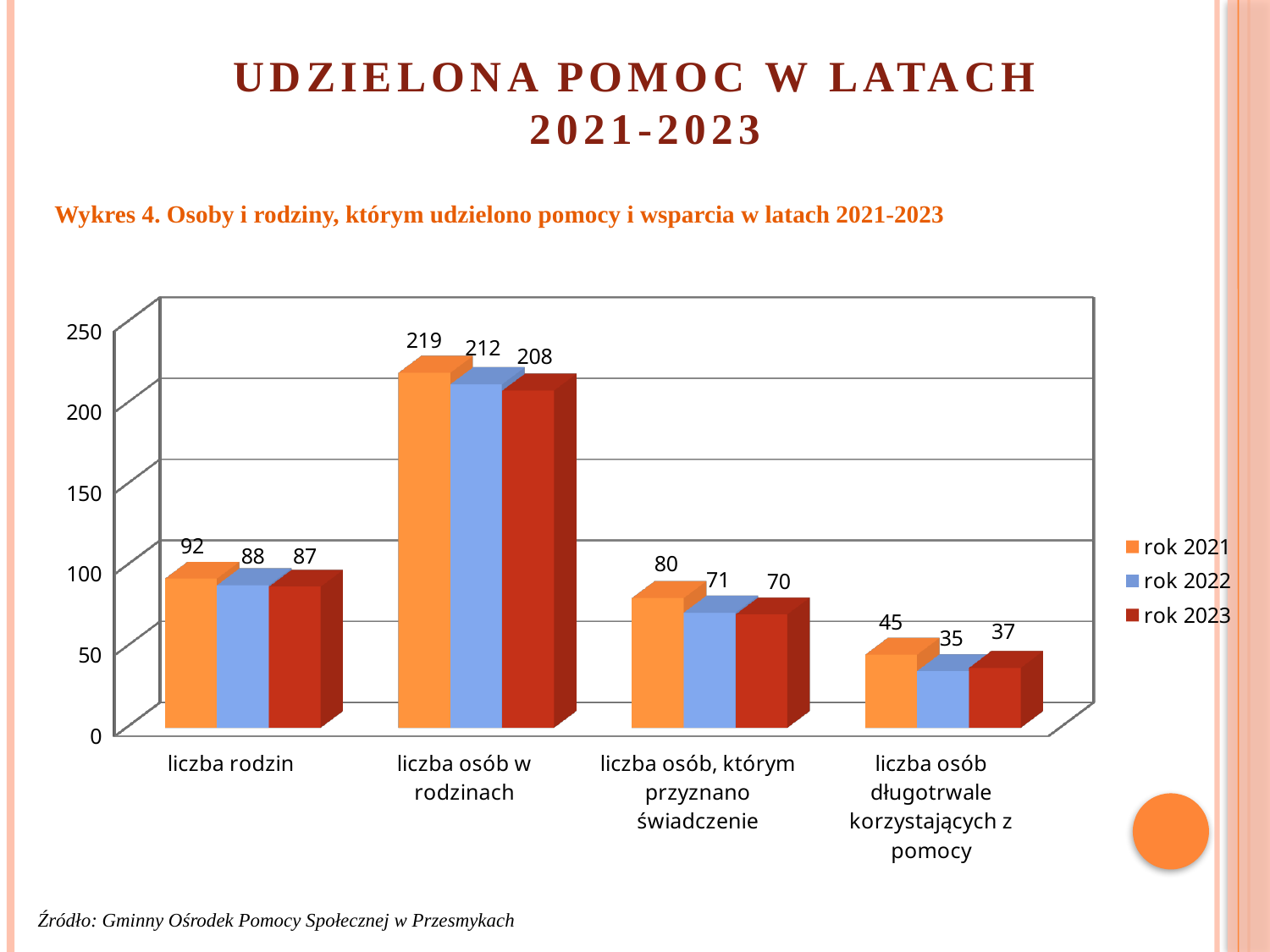
What is the difference between the 'rok 2021' and 'rok 2023' values for 'liczba osób, którym przyznano świadczenie'? 10 How many categories are shown on the x axis? 4 Which is larger for 'liczba osób długotrwale korzystających z pomocy': the 'rok 2022' value or the 'rok 2023' value? rok 2023 What is the value for 'liczba rodzin' in the 'rok 2021' series? 92 What is the value for 'liczba osób w rodzinach' in the 'rok 2023' series? 208 Which colour represents the 'rok 2022' series in the legend? blue What is the value for 'liczba osób długotrwale korzystających z pomocy' in the 'rok 2022' series? 35 What kind of chart is shown on the slide? bar chart Which category has the highest value in the 'rok 2021' series? liczba osób w rodzinach Do the values for 'liczba rodzin' rise or fall from 'rok 2021' to 'rok 2023'? fall How many series does the legend list? 3 Which category has the lowest value in the 'rok 2023' series? liczba osób długotrwale korzystających z pomocy